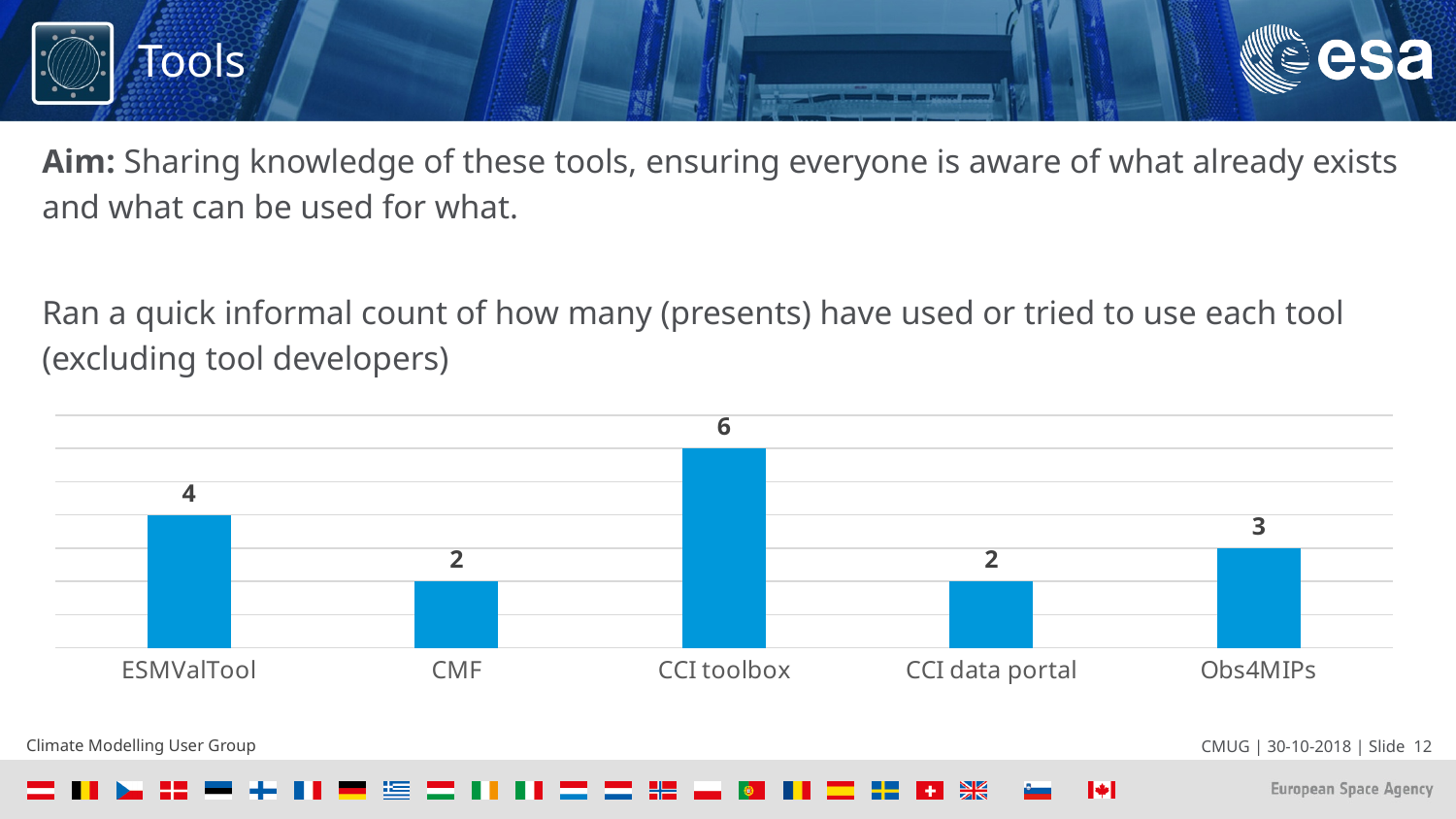
What is the value for Obs4MIPs? 3 What is the value for ESMValTool? 4 Which is larger, the value for ESMValTool or the value for Obs4MIPs? ESMValTool Which two tools share the same value of 2? CMF and CCI data portal What is the difference between the values for CCI toolbox and ESMValTool? 2 What is the value for CCI toolbox? 6 Which tool has the highest value? CCI toolbox What colour are the bars in the chart? Blue What is the value for CMF? 2 What kind of chart is shown on the slide? Bar chart How many tools (categories) are shown in the chart? 5 What is the difference between the values for Obs4MIPs and CMF? 1